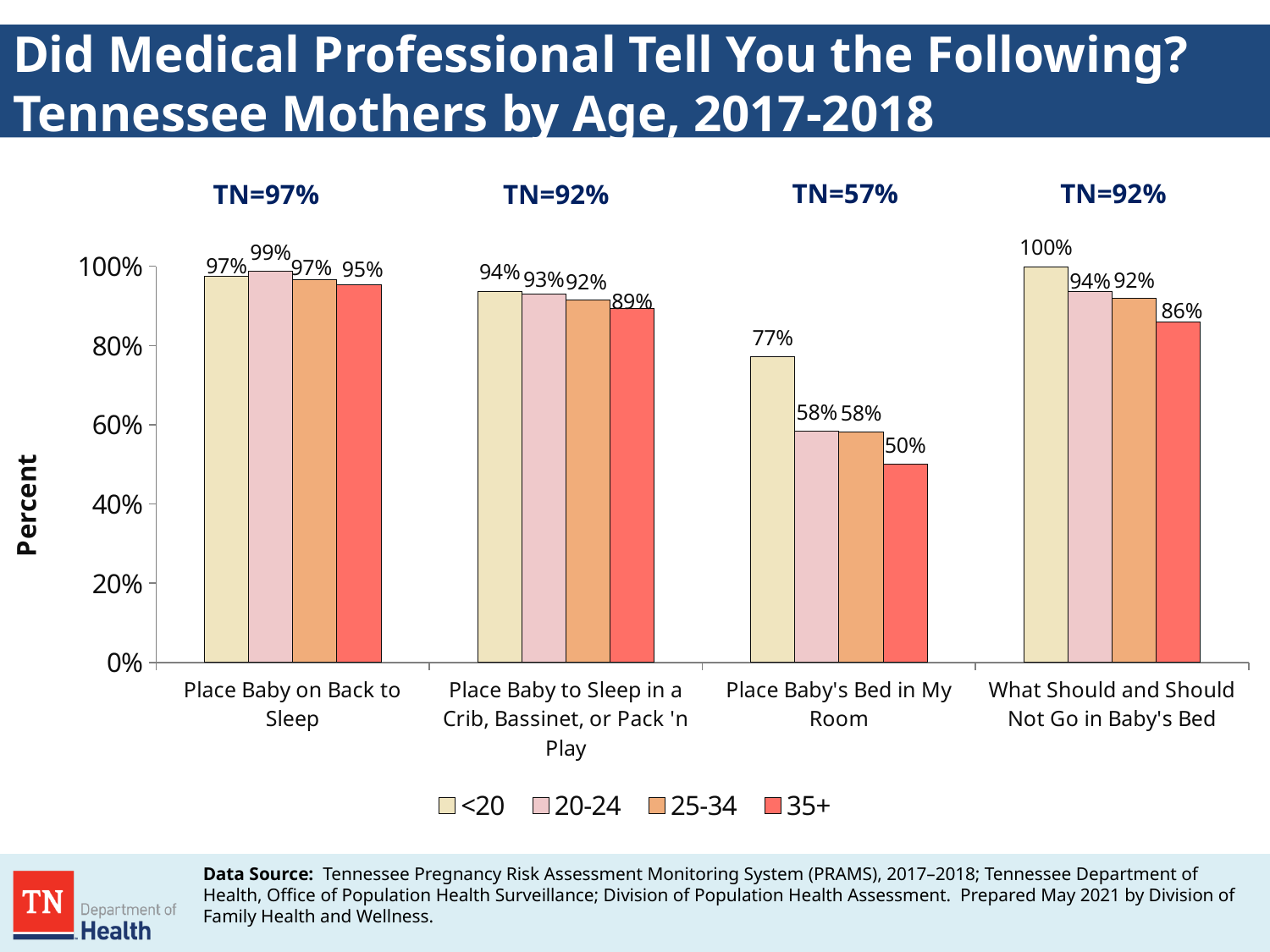
Which age group has the lowest value for 'Place Baby to Sleep in a Crib, Bassinet, or Pack 'n Play'? 35+ Which is larger for the 25-34 age group: 'Place Baby on Back to Sleep' or 'What Should and Should Not Go in Baby's Bed'? Place Baby on Back to Sleep Which age group has the highest value for 'Place Baby's Bed in My Room'? <20 Is the value for the 20-24 age group for 'Place Baby's Bed in My Room' greater or less than 60%? less What is the value for the 20-24 age group for 'Place Baby on Back to Sleep'? 99% What is the difference between the <20 and 35+ values for 'Place Baby's Bed in My Room'? 27% How many question categories are shown on the x axis? 4 What kind of chart is shown on the slide? bar chart How many age groups does the legend list? 4 What percentage of mothers aged 35+ were told to place baby's bed in my room? 50% What percentage of mothers under 20 were told what should and should not go in baby's bed? 100% What is the Tennessee overall value (TN=) shown above 'Place Baby's Bed in My Room'? 57%